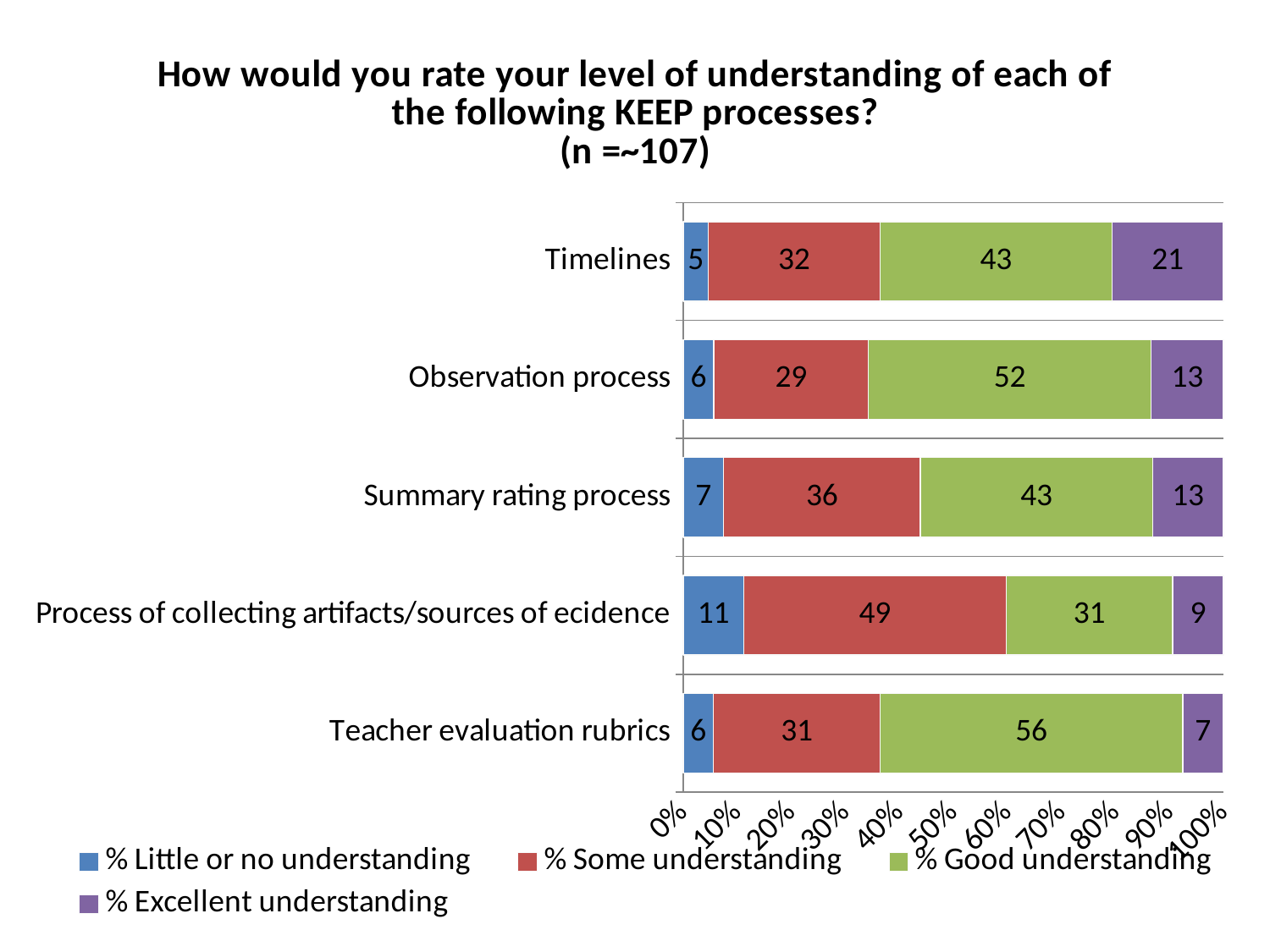
What is the total of the four segments in the Timelines bar? 101 What is the difference between the % Good understanding values for Teacher evaluation rubrics and Summary rating process? 13 Which process has the lowest value for % Excellent understanding? Teacher evaluation rubrics Which process has the highest value for % Little or no understanding? Process of collecting artifacts/sources of ecidence How many series does the legend list? 4 How many KEEP processes are shown on the chart? 5 Which process has the highest value for % Good understanding? Teacher evaluation rubrics Which is larger: the % Some understanding value for Summary rating process or for Observation process? Summary rating process What is the value for % Excellent understanding for Timelines? 21 What kind of chart is shown on the slide? Stacked bar chart What is the value for % Some understanding for the process of collecting artifacts/sources of evidence? 49 What percentage of respondents reported good understanding of the observation process? 52